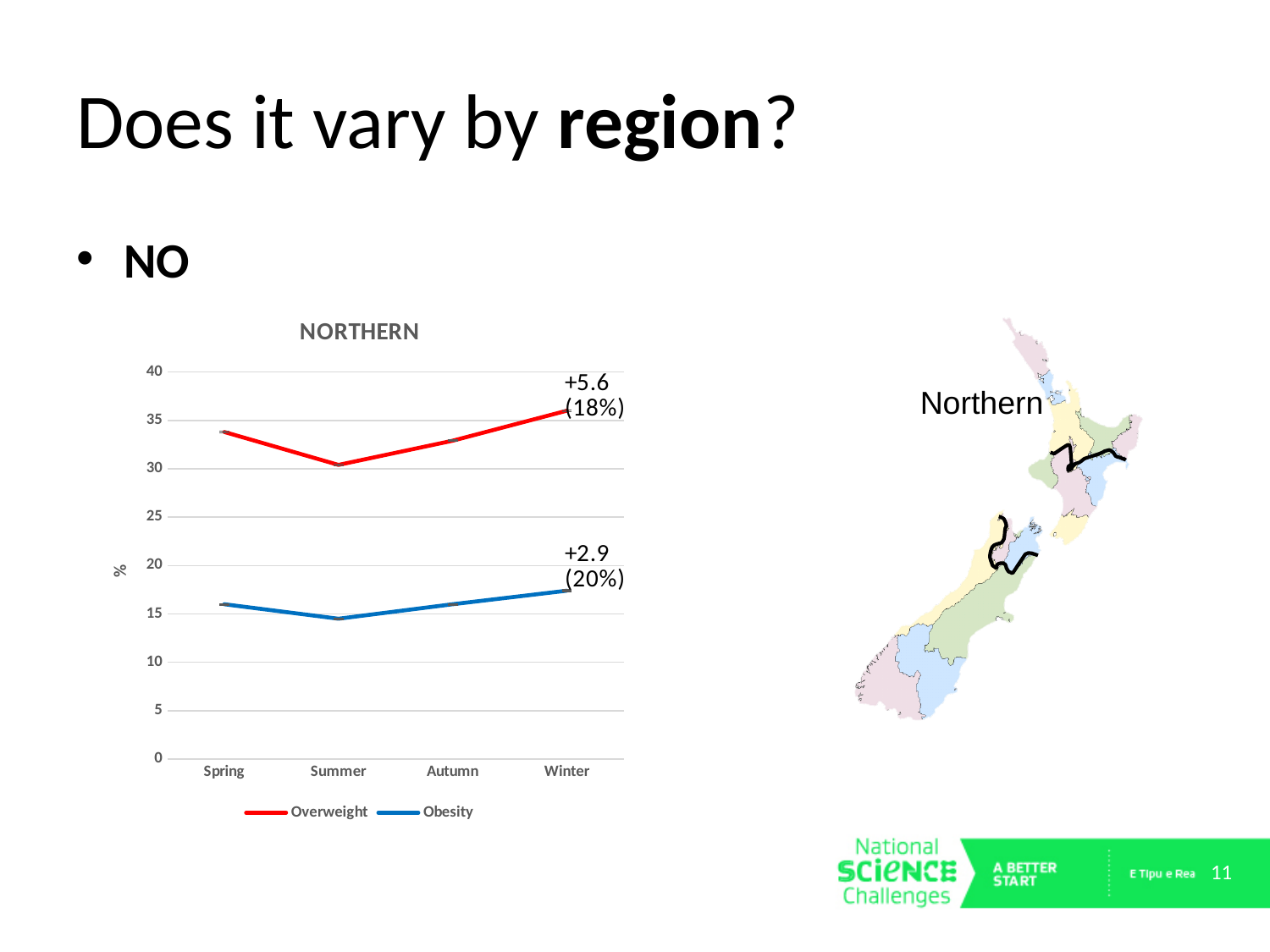
Is the Obesity value for Winter greater or less than 15? greater What is the title of the chart? NORTHERN Which series has the larger value in Autumn, Overweight or Obesity? Overweight In which season is the Obesity value lowest? Summer Does the Overweight line rise or fall from Summer to Winter? rise In which season is the Overweight value lowest? Summer Is the Overweight value for Spring greater or less than 30? greater How many series does the chart legend list? 2 How many seasons are shown on the x axis of the chart? 4 Is the Overweight value for Summer greater or less than 35? less In which season is the Overweight value highest? Winter What type of chart is shown on the slide? line chart